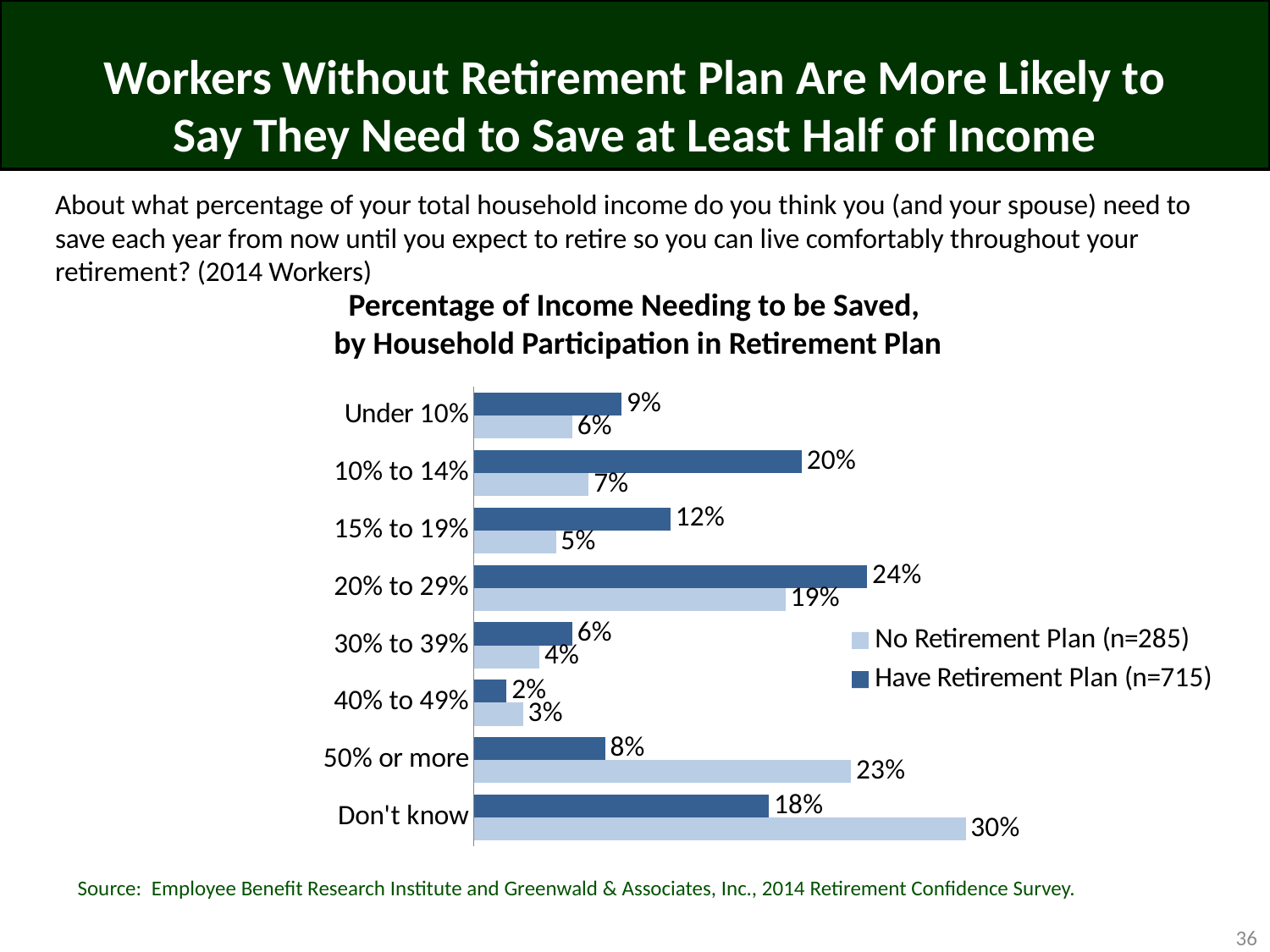
What percentage of workers with no retirement plan say they need to save 50% or more of income? 23% What is the sample size (n) for the No Retirement Plan series shown in the legend? 285 Which category has the highest value for the Have Retirement Plan series? 20% to 29% What is the title of the chart? Percentage of Income Needing to be Saved, by Household Participation in Retirement Plan What percentage of workers with no retirement plan answered 'Don't know'? 30% What is the difference between the No Retirement Plan and Have Retirement Plan values for the '50% or more' category? 15 percentage points What kind of chart is shown on the slide? Bar chart For the '20% to 29%' category, which series has the larger value: No Retirement Plan or Have Retirement Plan? Have Retirement Plan How many categories are shown on the chart? 8 Which category has the lowest value for the Have Retirement Plan series? 40% to 49% What percentage of workers who have a retirement plan say they need to save 10% to 14% of income? 20% How many series does the legend list? 2